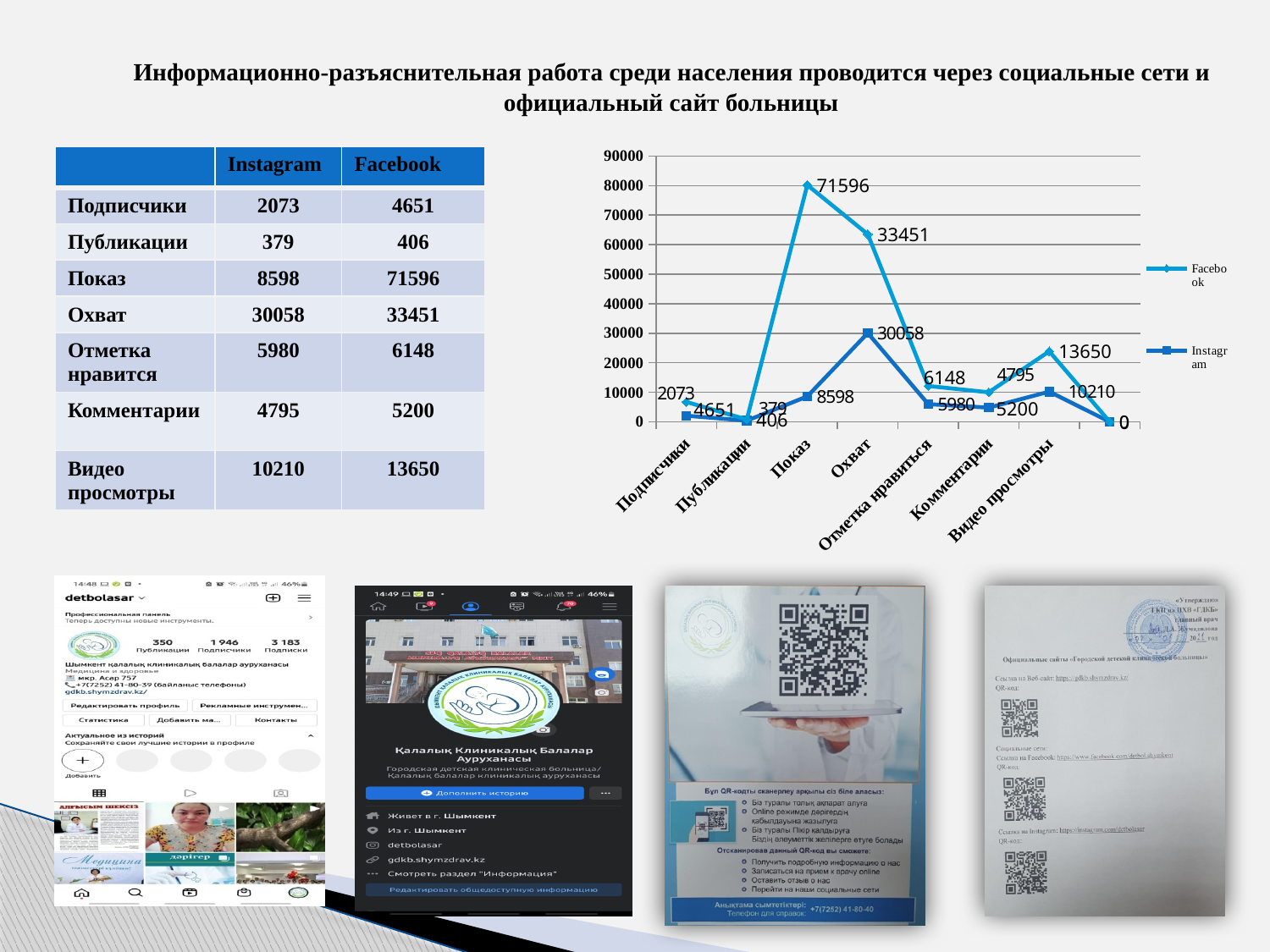
What is the Instagram value for Комментарии in the chart? 4795 Which category has the highest Instagram value in the chart? Охват What is the difference between the Facebook and Instagram values for Подписчики? 2578 What is the Instagram value for Охват in the chart? 30058 Which series is drawn in the darker blue line in the chart? Instagram What is the Facebook value for Видео просмотры in the chart? 13650 Which category has the highest Facebook value in the chart? Показ Is the Facebook value for Охват greater or less than 30000? greater Which is larger in the chart: the Facebook value for Показ or the Instagram value for Показ? Facebook How many series does the chart legend list? 2 What type of chart is shown on the slide? line chart What is the Facebook value for Показ in the chart? 71596